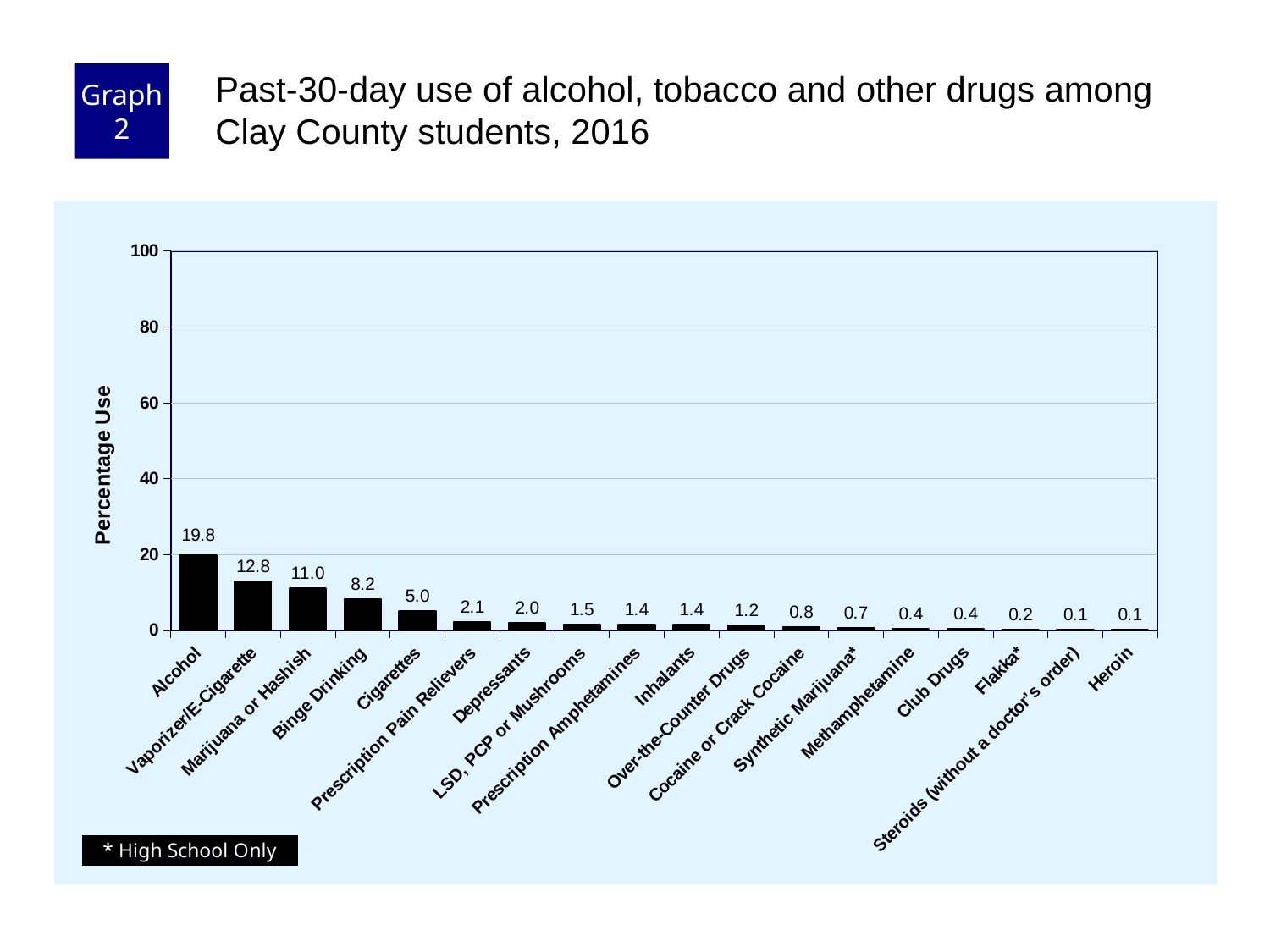
What is the difference between the values for Cigarettes and Prescription Pain Relievers? 2.9 What is the percentage use value for Alcohol? 19.8 What kind of chart is shown on the slide? bar chart What is the percentage use value for Cocaine or Crack Cocaine? 0.8 What is the percentage use value for Vaporizer/E-Cigarette? 12.8 What is the percentage use value for Binge Drinking? 8.2 Which category has the highest percentage use? Alcohol Is the value for Alcohol greater or less than 20? less What is the difference between the values for Alcohol and Marijuana or Hashish? 8.8 Which is larger, the value for Depressants or the value for Inhalants? Depressants What is the label of the y axis? Percentage Use How many categories are shown on the x axis? 18